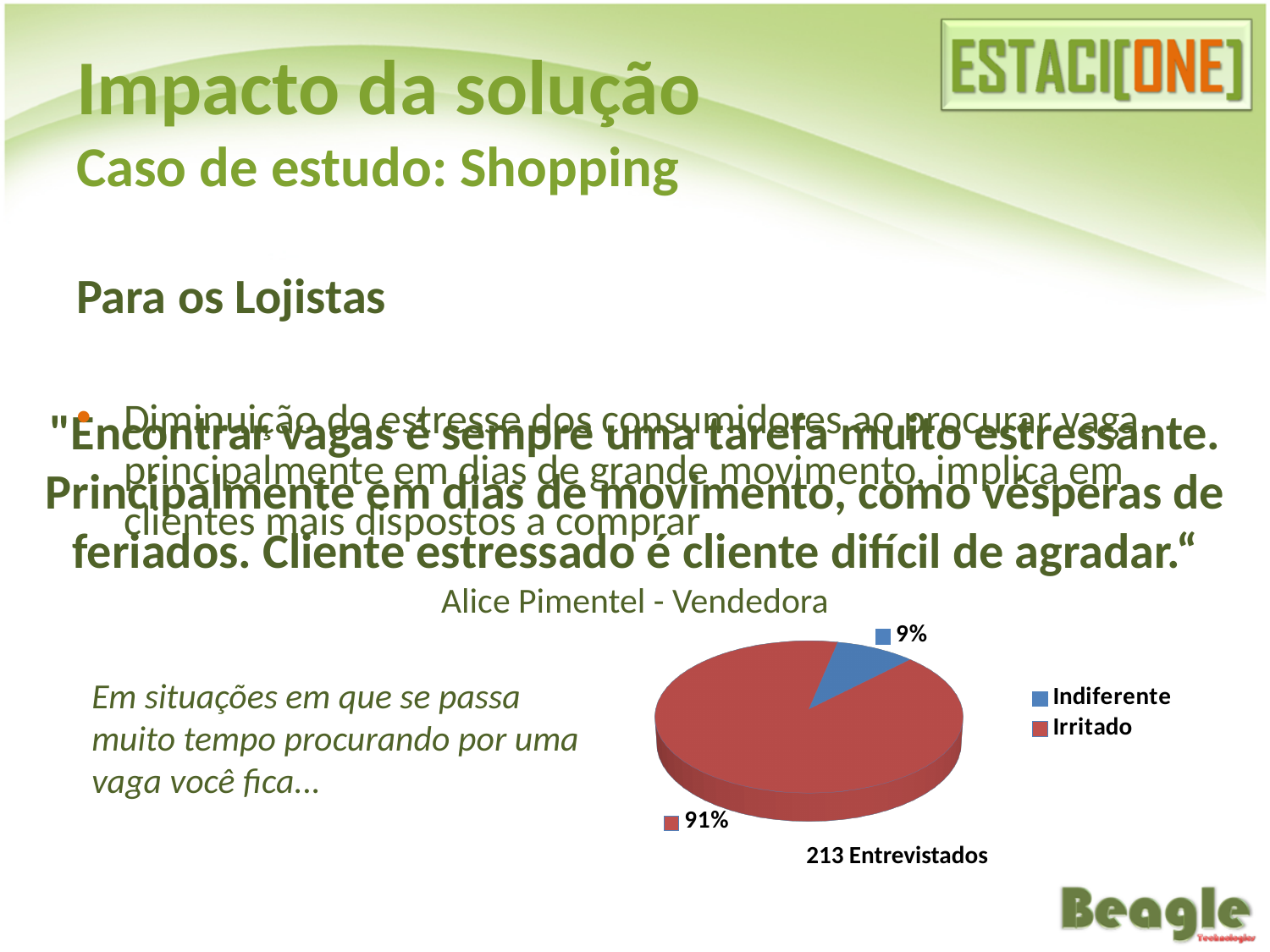
Which category has the largest slice of the pie chart? Irritado What percentage of the pie chart is labelled Irritado? 91% Which category has the smallest slice of the pie chart? Indiferente What is the difference in percentage points between the Irritado and Indiferente slices? 82 How many respondents (entrevistados) does the text below the chart say were surveyed? 213 What percentage of the pie chart is labelled Indiferente? 9% Which slice is larger, Indiferente or Irritado? Irritado What colour is the Irritado slice in the pie chart? red What share of the pie does the Indiferente slice represent? 9% How many entries does the chart legend list? 2 How many slices does the pie chart have? 2 What kind of chart is shown on the slide? pie chart